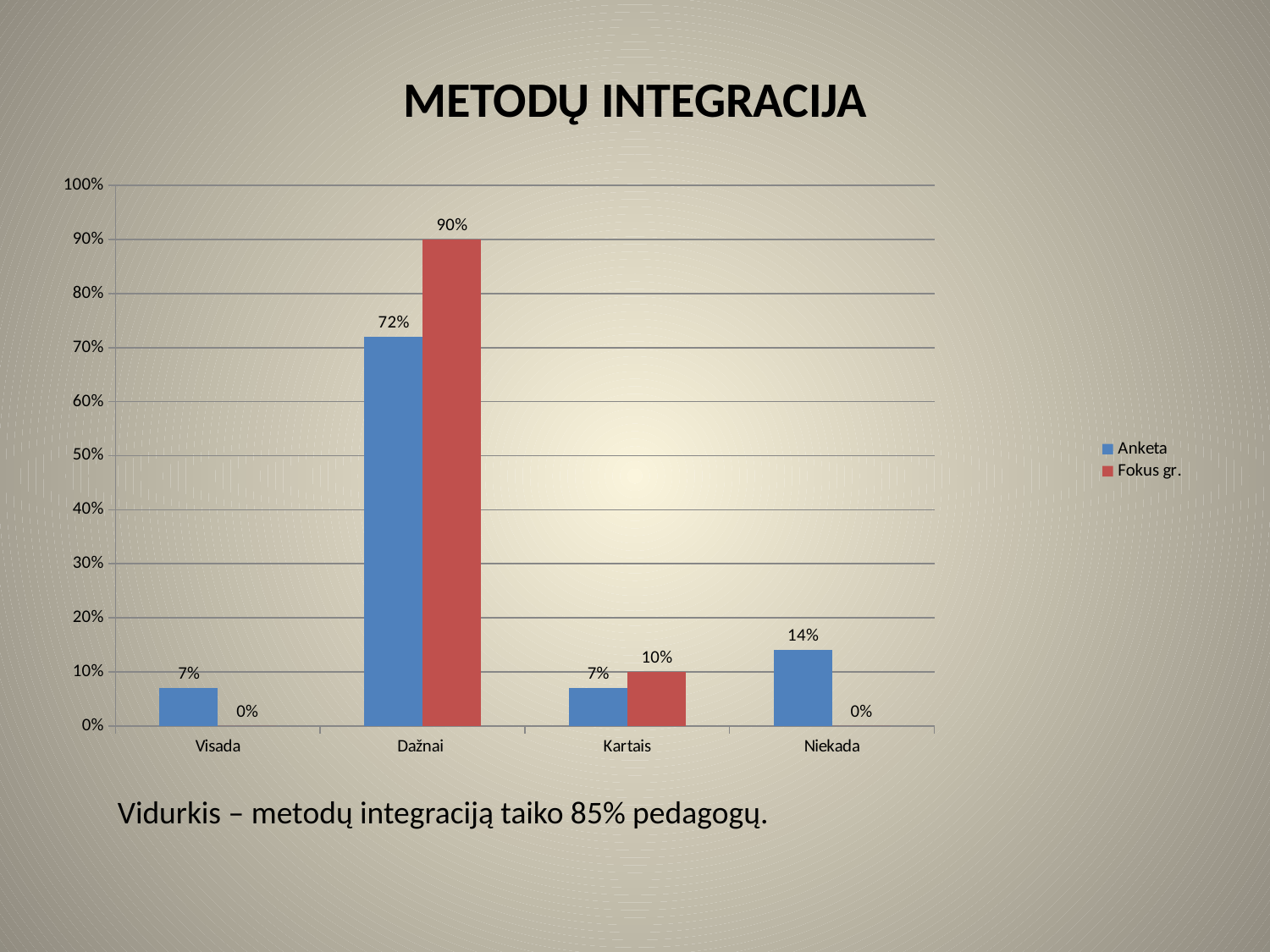
Which category has the lowest Anketa value? Visada and Kartais (both 7%) Which is larger for Kartais, the Anketa value or the Fokus gr. value? Fokus gr. What is the difference between the Fokus gr. and Anketa values for Dažnai? 18% What is the Fokus gr. value for Dažnai? 90% Which category has the highest Anketa value? Dažnai What is the Fokus gr. value for Kartais? 10% How many series does the legend list? 2 What kind of chart is shown on the slide? Bar chart What is the Anketa value for Dažnai? 72% What is the Anketa value for Niekada? 14% How many categories are shown on the x axis? 4 What is the Fokus gr. value for Visada? 0%